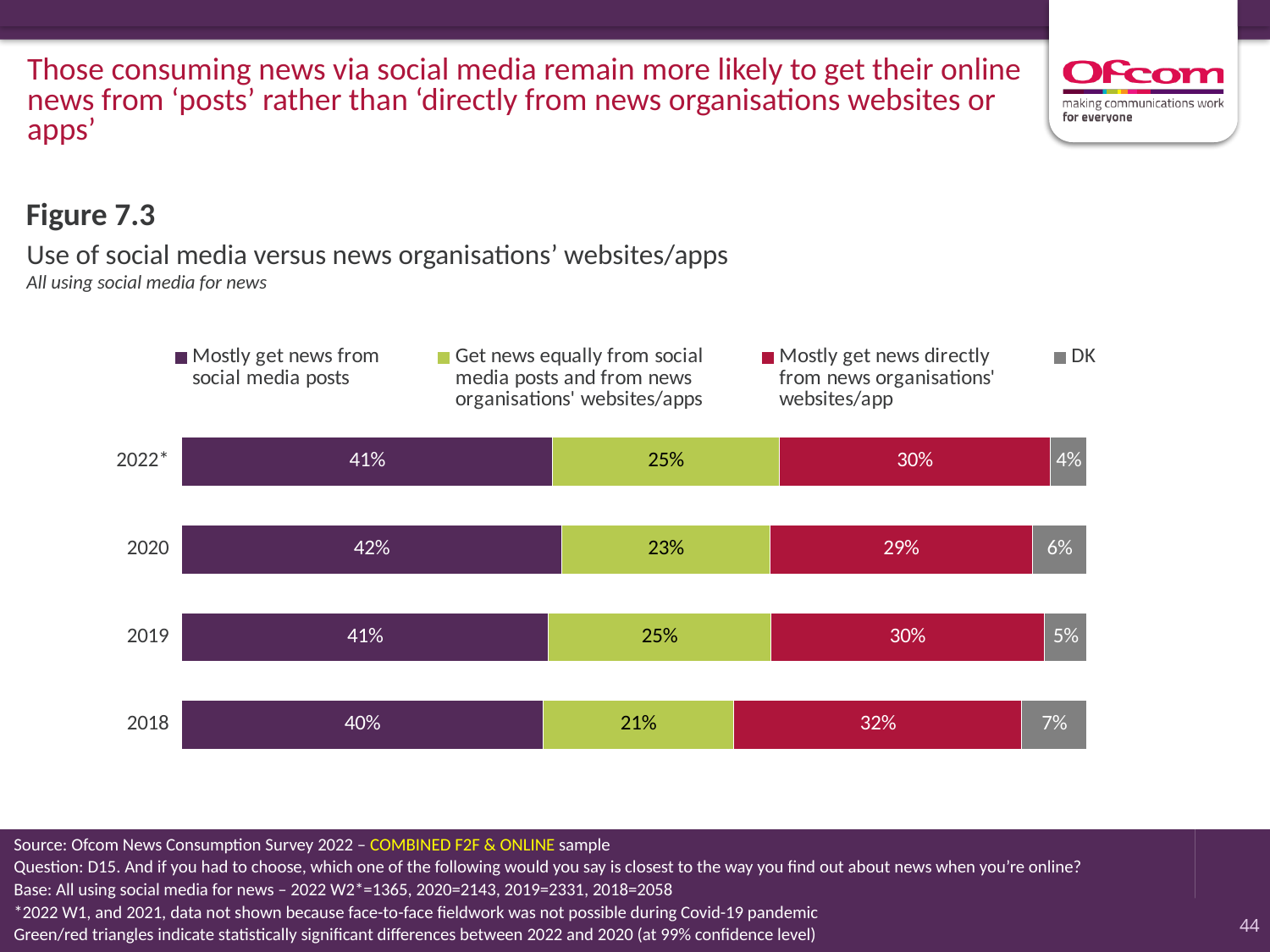
What type of chart is shown? Stacked bar chart In 2018, which is larger: the share who mostly get news from social media posts or the share who mostly get news directly from news organisations' websites/app? Mostly get news from social media posts How many series does the legend list? 4 What is the DK value for 2020? 6% Which year has the highest value for 'Mostly get news from social media posts'? 2020 What percentage of respondents in 2018 mostly get news directly from news organisations' websites/app? 32% What percentage of respondents in 2022* mostly get news from social media posts? 41% What percentage in 2019 get news equally from social media posts and from news organisations' websites/apps? 25% Which year has the lowest value for 'Get news equally from social media posts and from news organisations' websites/apps'? 2018 How many years are shown on the chart? 4 What is the figure number of the chart? Figure 7.3 What is the difference between the 'Mostly get news from social media posts' and 'Mostly get news directly from news organisations' websites/app' values in 2022*? 11 percentage points